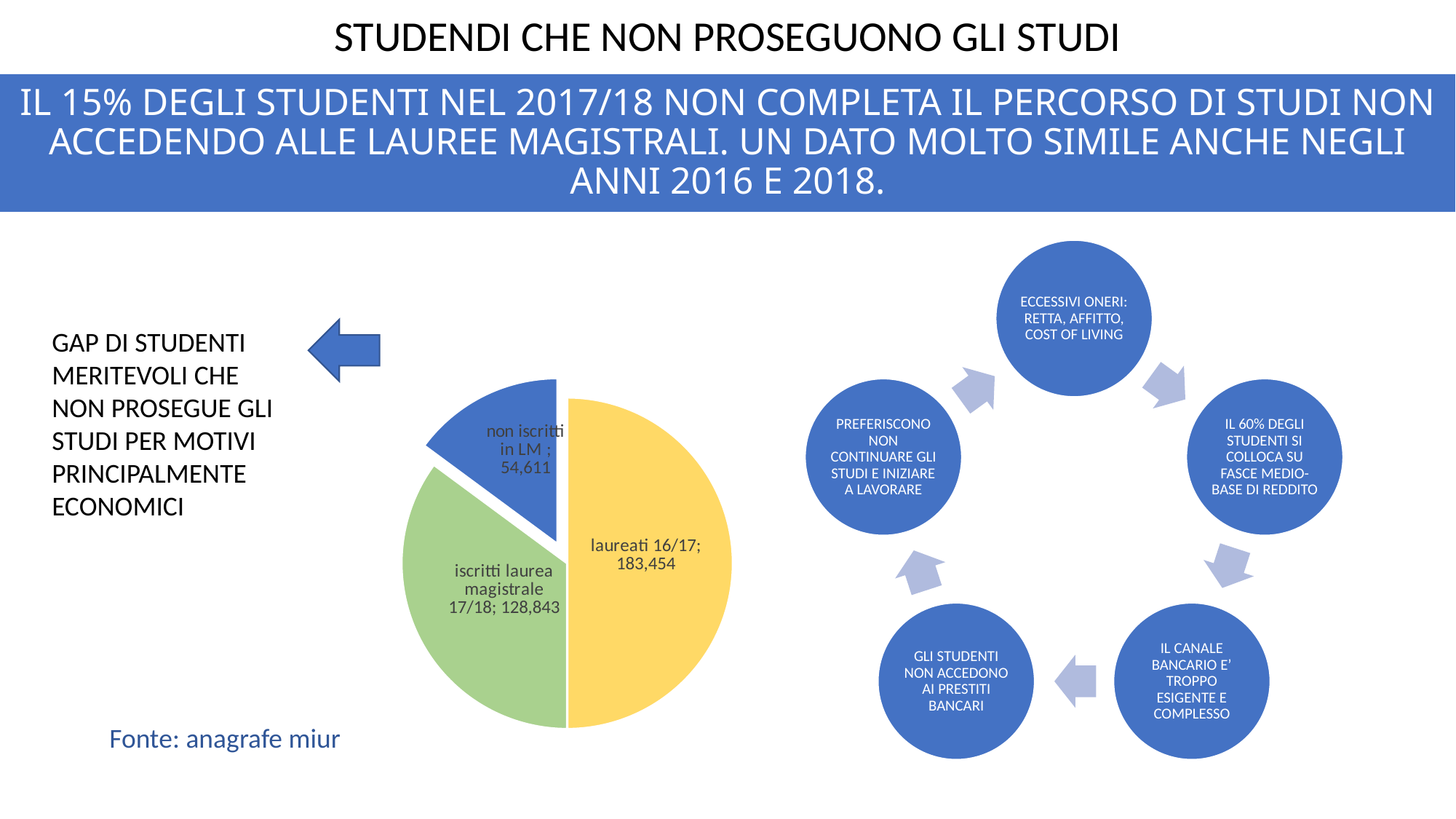
What value is shown for the 'non iscritti in LM' slice of the pie chart? 54,611 Which slice of the pie chart has the smallest value? non iscritti in LM What colour is the 'non iscritti in LM' slice of the pie chart? blue Which slice of the pie chart has the largest value? laureati 16/17 What type of chart is shown on the slide? pie chart In the pie chart, which is larger: 'iscritti laurea magistrale 17/18' or 'non iscritti in LM'? iscritti laurea magistrale 17/18 What is the difference between the 'iscritti laurea magistrale 17/18' value and the 'non iscritti in LM' value in the pie chart? 74,232 What value is shown for the 'iscritti laurea magistrale 17/18' slice of the pie chart? 128,843 What share of the pie chart total does the 'laureati 16/17' slice represent? 50% What value is shown for the 'laureati 16/17' slice of the pie chart? 183,454 How many slices does the pie chart have? 3 What is the difference between the 'laureati 16/17' value and the 'iscritti laurea magistrale 17/18' value in the pie chart? 54,611